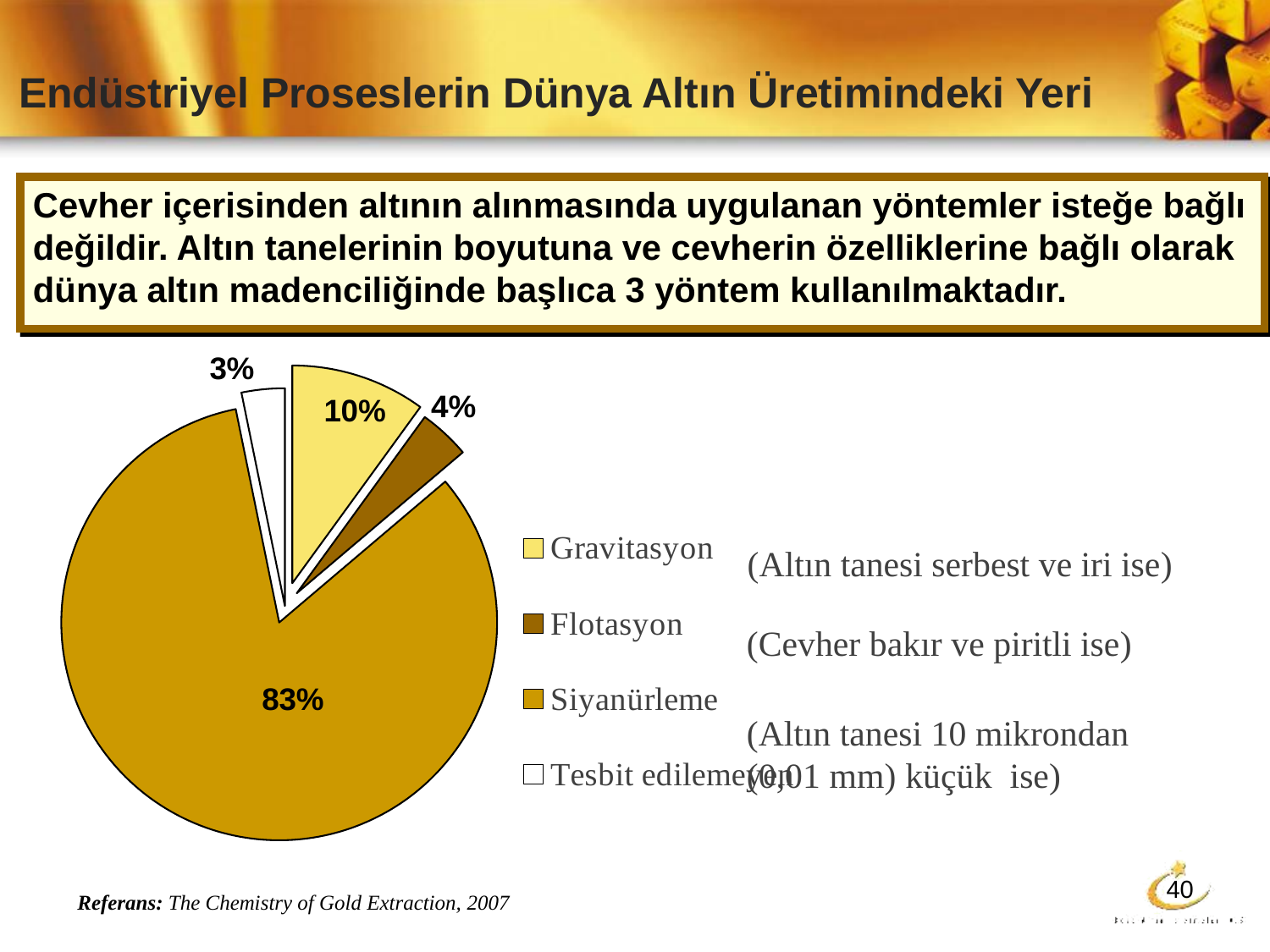
What type of chart is shown on the slide? pie chart What share of the pie does Siyanürleme account for? 83% What share of the pie does Flotasyon account for? 4% Which legend entry is shown with a dark brown colour? Flotasyon How many entries does the legend list? 4 What is the difference in percentage points between Siyanürleme and Gravitasyon? 73 Which category has the largest slice of the pie? Siyanürleme How many slices does the pie chart have? 4 What share of the pie does Gravitasyon account for? 10% What is the difference in percentage points between Gravitasyon and Flotasyon? 6 What percentage is shown for the white slice of the pie? 3% Which of Gravitasyon and Flotasyon has the larger share? Gravitasyon